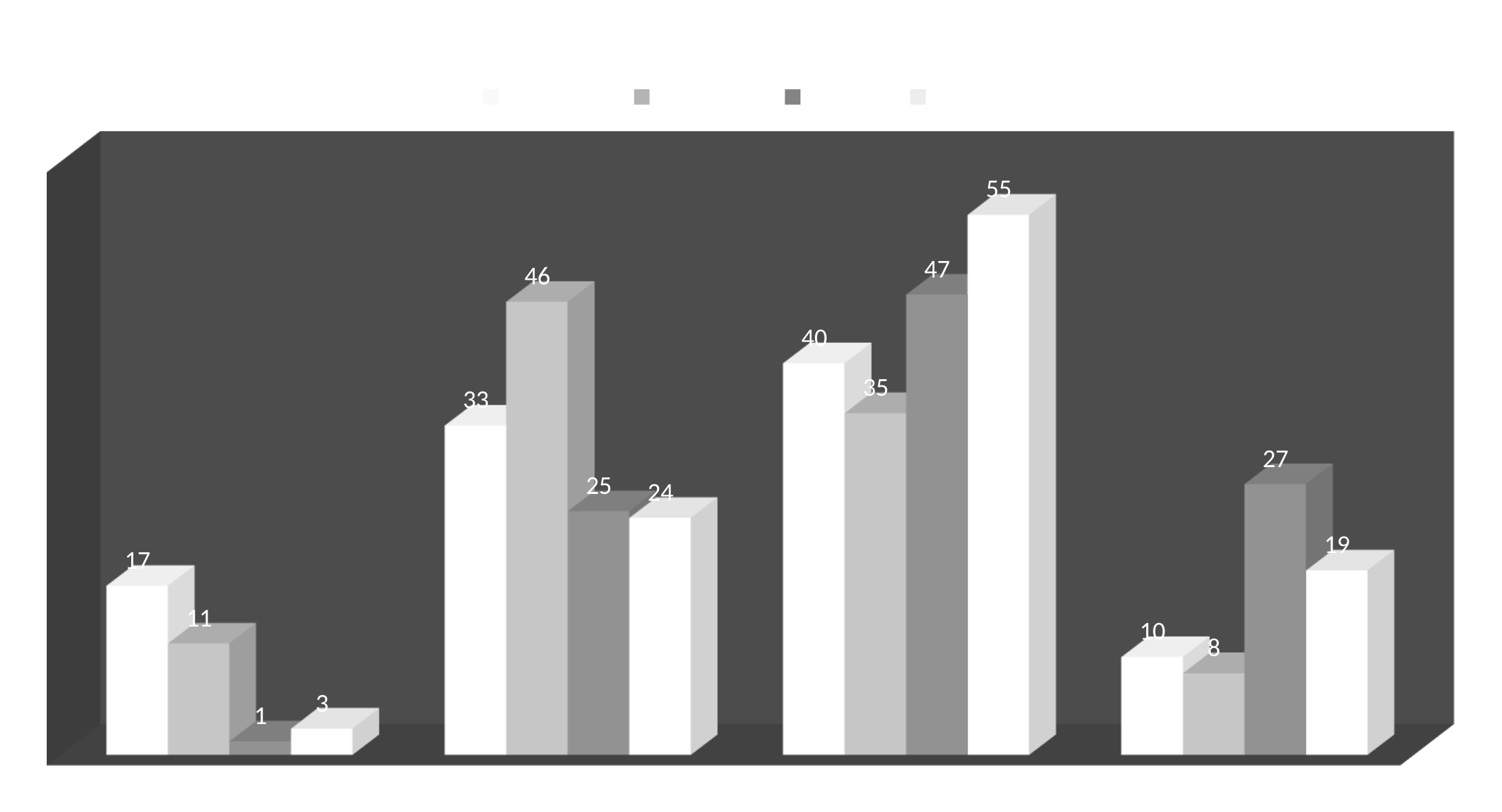
What is the highest data label shown on the chart? 55 What is the lowest data label shown on the chart? 1 What is the value of the second bar in the second group from the left? 46 What is the difference between the first bar (10) and the second bar (8) in the rightmost group? 2 Which is larger: the first bar in the third group (40) or the first bar in the second group (33)? 40 How many groups of bars are plotted along the x axis? 4 What is the value of the third bar in the rightmost group? 27 What is the difference between the tallest bar in the third group (55) and the tallest bar in the second group (46)? 9 Which group of bars contains the bar with the value 55? the third group from the left What kind of chart is shown on the slide? bar chart What is the value of the tallest bar in the leftmost group? 17 How many series does the legend list? 4